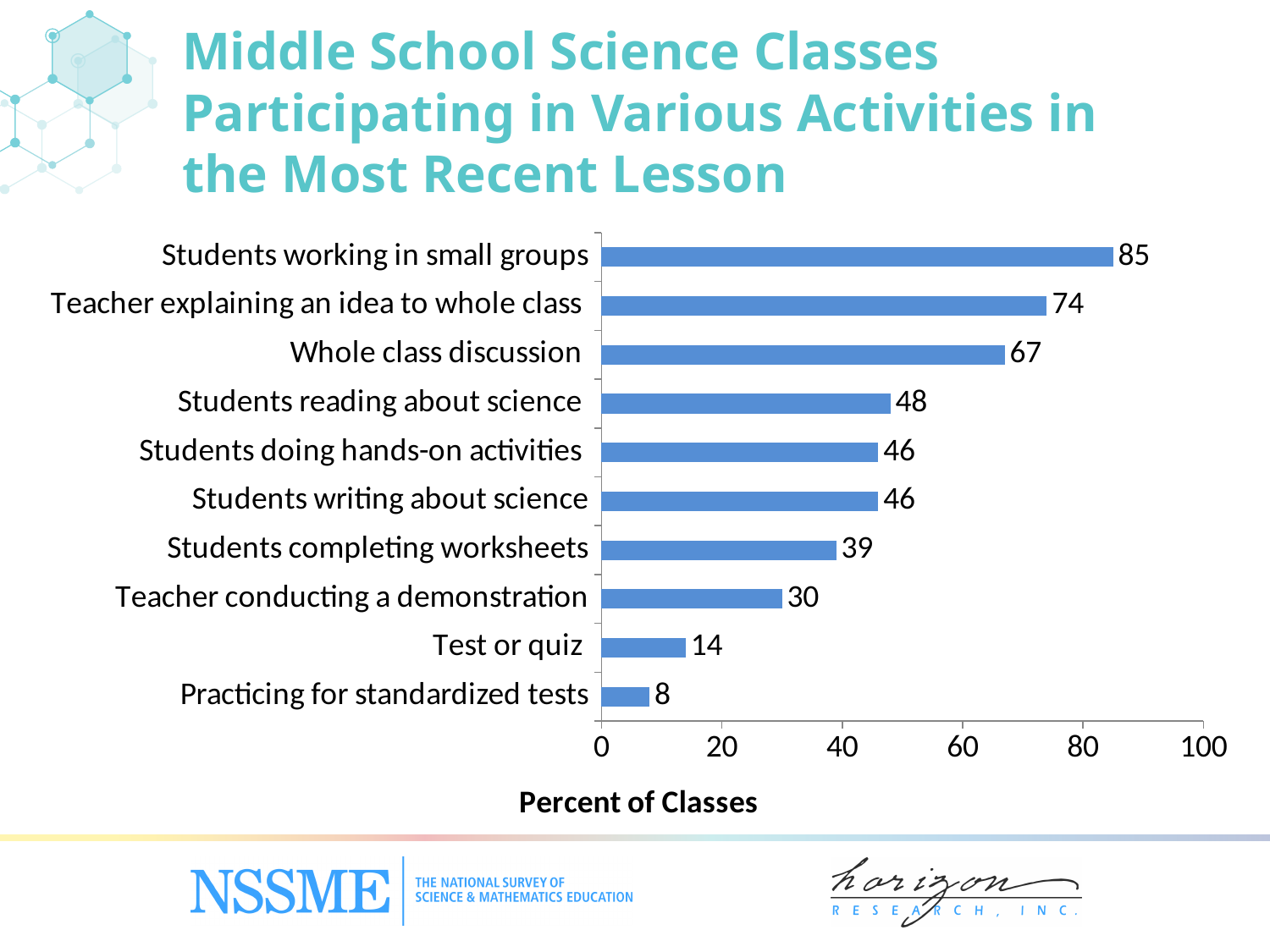
How many activities are shown in the chart? 10 Which activity has the highest percent of classes? Students working in small groups Which is larger, the value for Students reading about science or the value for Students completing worksheets? Students reading about science Which activity has the lowest percent of classes? Practicing for standardized tests What percent of classes had students working in small groups in the most recent lesson? 85 What is the maximum value shown on the horizontal axis? 100 What is the value for Teacher conducting a demonstration? 30 What is the label of the horizontal axis? Percent of Classes What is the difference between the values for Teacher explaining an idea to whole class and Whole class discussion? 7 What is the difference between the values for Test or quiz and Practicing for standardized tests? 6 What kind of chart is shown on the slide? Bar chart What is the value for Students completing worksheets? 39